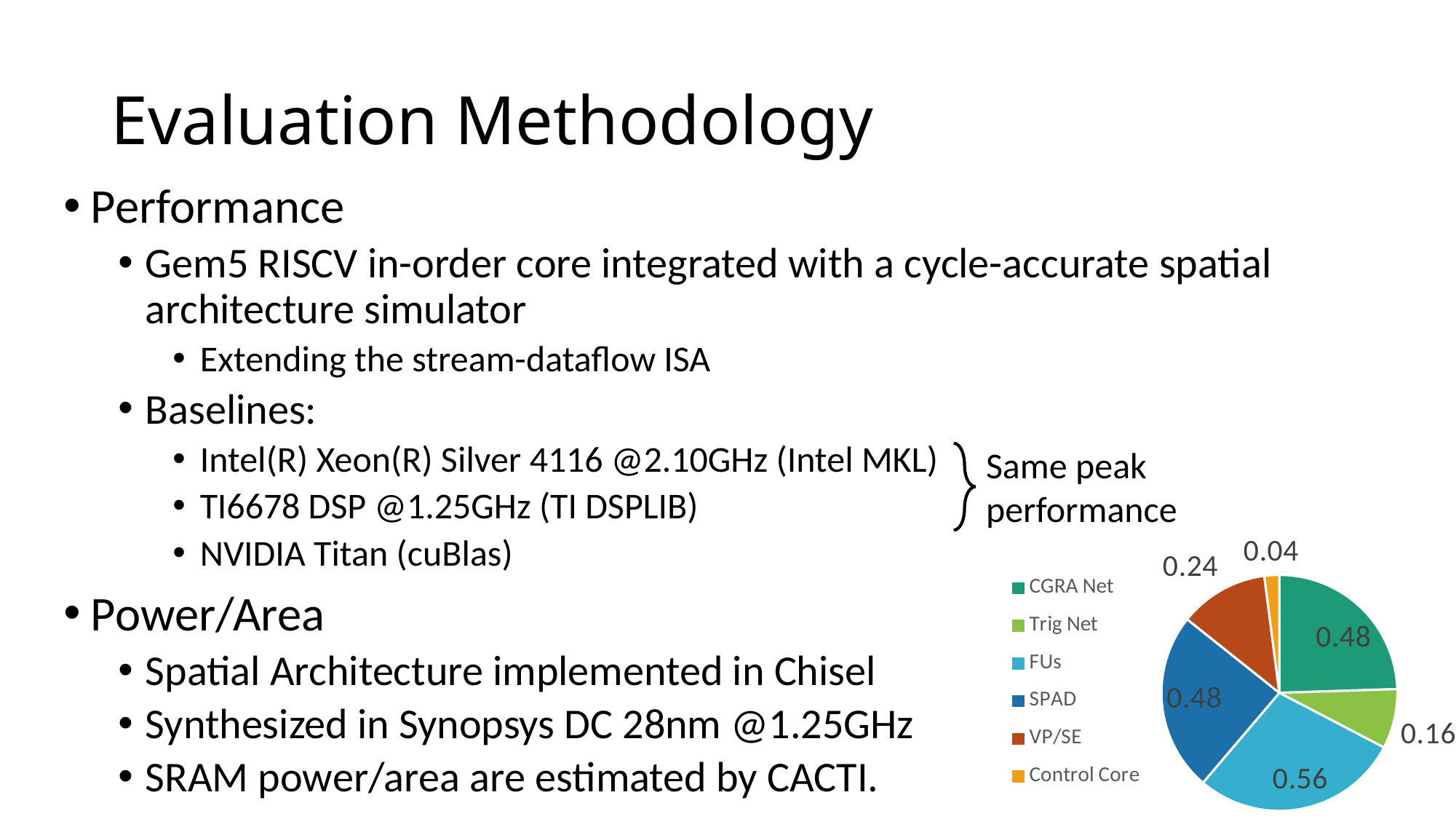
What is the difference between the values for FUs and Trig Net? 0.4 Which category has the smallest slice in the pie chart? Control Core What is the value for VP/SE in the pie chart? 0.24 What is the value for FUs in the pie chart? 0.56 Which legend entry is shown in orange in the pie chart? Control Core How many categories does the pie chart have? 6 What is the value for CGRA Net in the pie chart? 0.48 What is the value for Trig Net in the pie chart? 0.16 Which is larger, the value for VP/SE or the value for Trig Net? VP/SE What is the value for Control Core in the pie chart? 0.04 What type of chart is shown on the slide? pie chart Which category has the largest slice in the pie chart? FUs